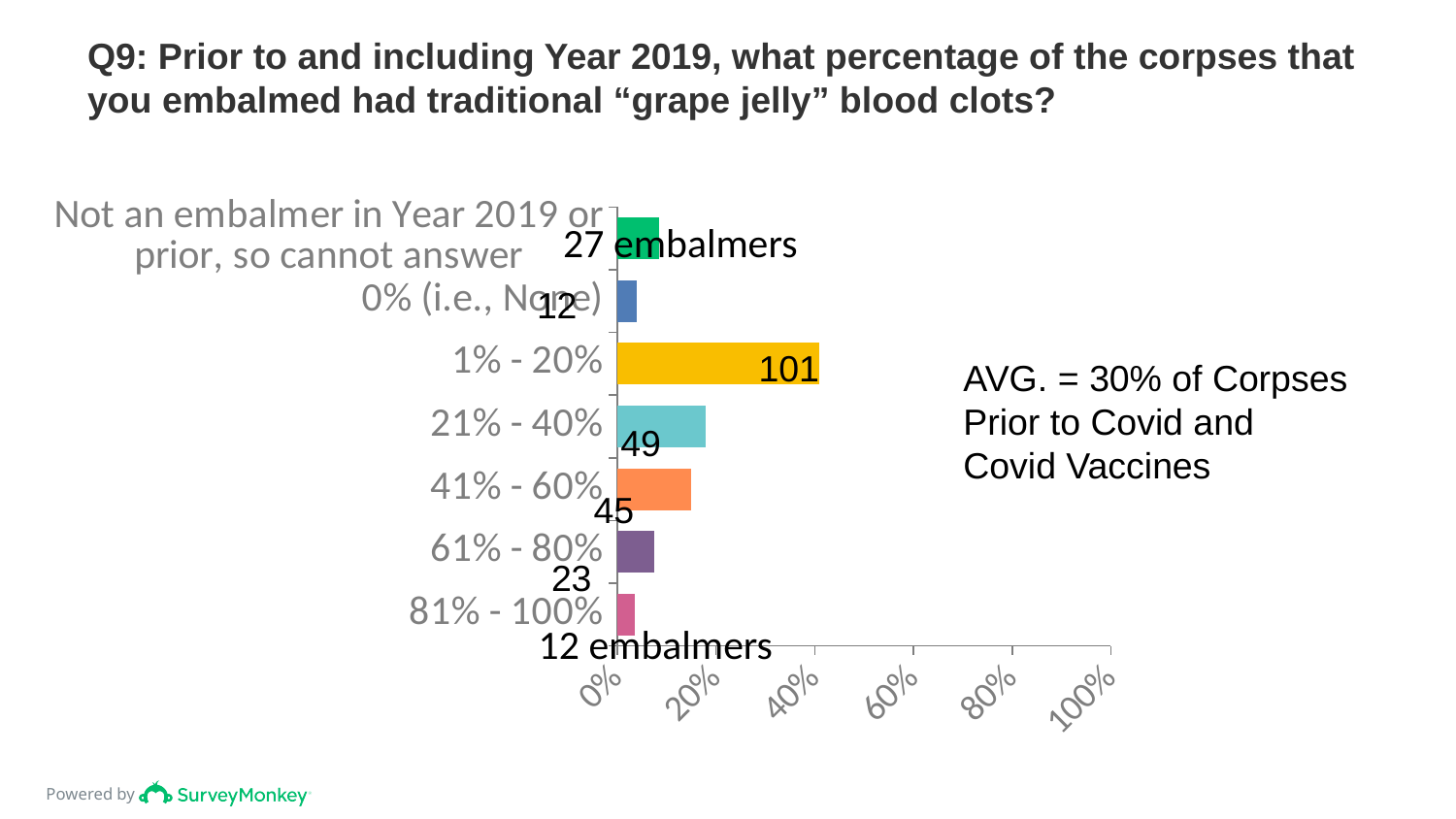
What number of embalmers is labelled for the "21% - 40%" category? 49 What number of embalmers is labelled for the "61% - 80%" category? 23 Which category has the longest bar in the chart? 1% - 20% What number of embalmers is labelled for the "1% - 20%" category? 101 What number of embalmers is labelled for the "41% - 60%" category? 45 How many categories are plotted in the chart? 7 Is the bar for "1% - 20%" greater or less than 20% on the axis? greater What kind of chart is shown on the slide? bar chart Which bar is longer: "1% - 20%" or "21% - 40%"? 1% - 20% Is the bar for "61% - 80%" greater or less than 20% on the axis? less What average percentage of corpses is stated in the text beside the chart? 30% What number of embalmers is labelled for the "Not an embalmer in Year 2019 or prior, so cannot answer" category? 27 embalmers